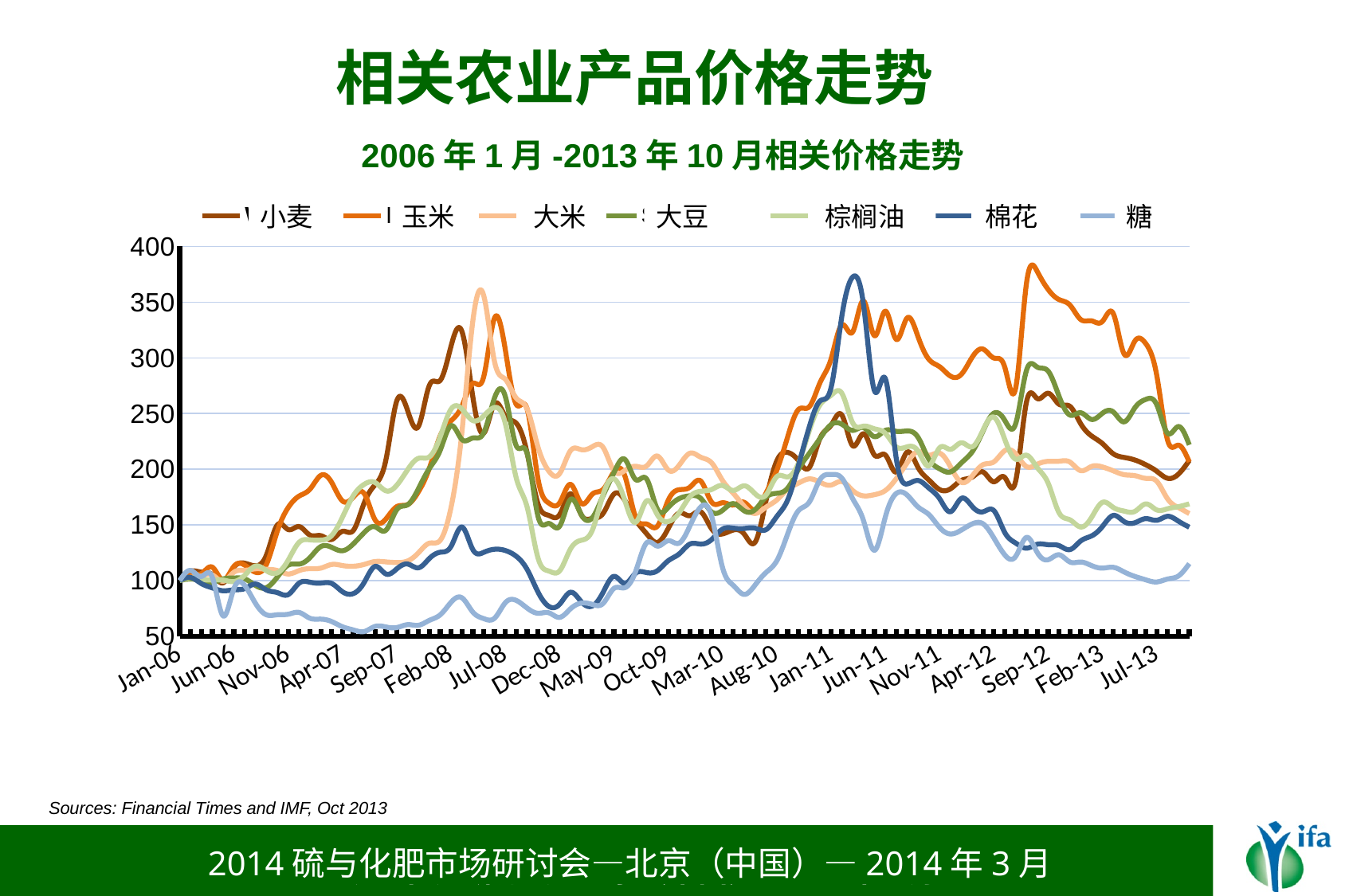
How many series does the legend list? 7 At Jul-08, which is larger, the value for 大米 or the value for 棉花? 大米 Which series has the lowest value at Jul-13? 糖 Is the value for 棉花 at Jul-13 greater or less than 200? less Does the value for 玉米 rise or fall from Sep-12 to Jul-13? fall Is the value for 糖 around Sep-07 greater or less than 100? less Which series has the highest value at Jul-13? 玉米 What is the title of the chart? 相关农业产品价格走势 Is the peak value for 大米 around Jul-08 greater or less than 300? greater What kind of chart is shown on the slide? line chart What is the source cited below the chart? Financial Times and IMF, Oct 2013